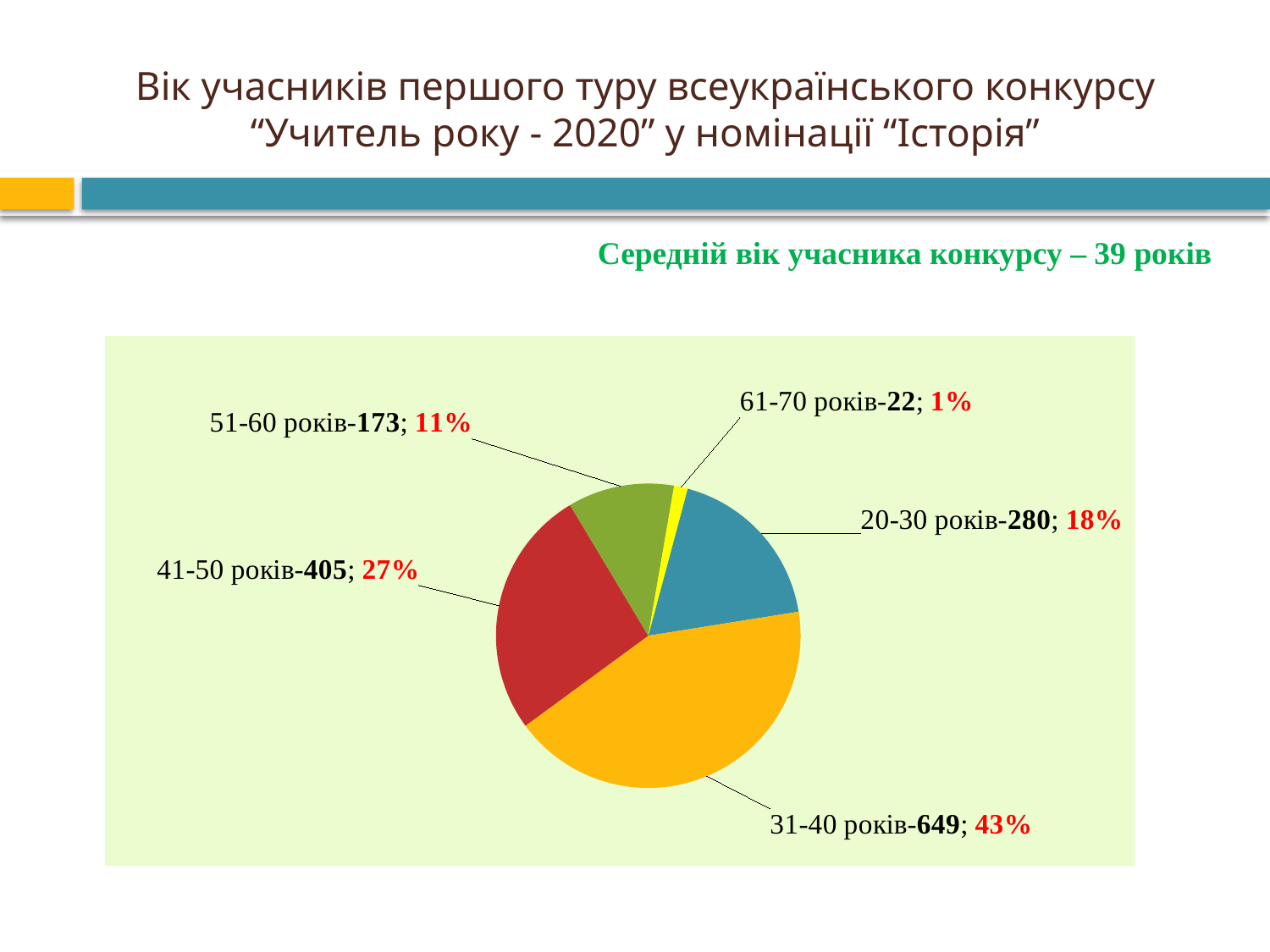
What is the total number of participants across all age groups in the pie chart? 1529 Which age group has the smallest slice of the pie? 61-70 років Which age group has the largest slice of the pie? 31-40 років What kind of chart is shown on the slide? pie chart What is the difference in participants between the 31-40 років and 41-50 років groups? 244 What percentage share is shown for the 20-30 років group? 18% What colour is the slice for the 41-50 років group? red How many participants are in the 61-70 років age group? 22 How many slices does the pie chart have? 5 What share of the pie does the 41-50 років group represent? 27% Which group has more participants: 20-30 років or 51-60 років? 20-30 років How many participants are in the 31-40 років age group? 649